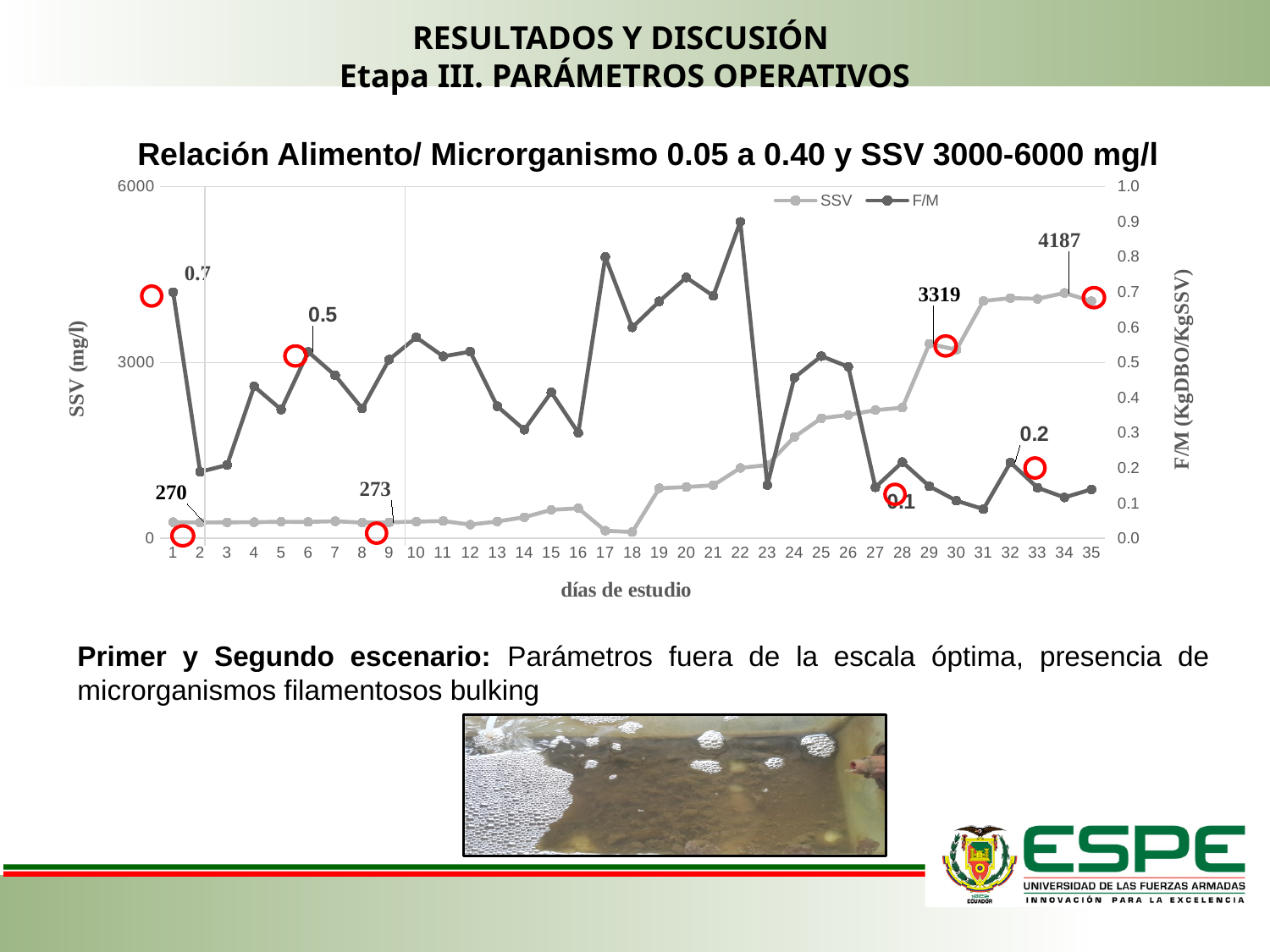
What is the difference between the labelled F/M values on day 1 (0.7) and day 6 (0.5)? 0.2 What is the F/M value labelled on day 1? 0.7 Which is larger, the SSV value on day 34 or on day 1? day 34 How many series does the chart legend list? 2 What kind of chart is shown on the slide? line chart What is the difference between the labelled SSV values on day 34 (4187) and day 29 (3319)? 868 Is the F/M value on day 22 greater or less than 0.8? greater On which day does the F/M series reach its highest value? 22 What is the title of the chart? Relación Alimento/ Microrganismo 0.05 a 0.40 y SSV 3000-6000 mg/l What is the SSV value labelled on day 34? 4187 How many study days are plotted along the x axis? 35